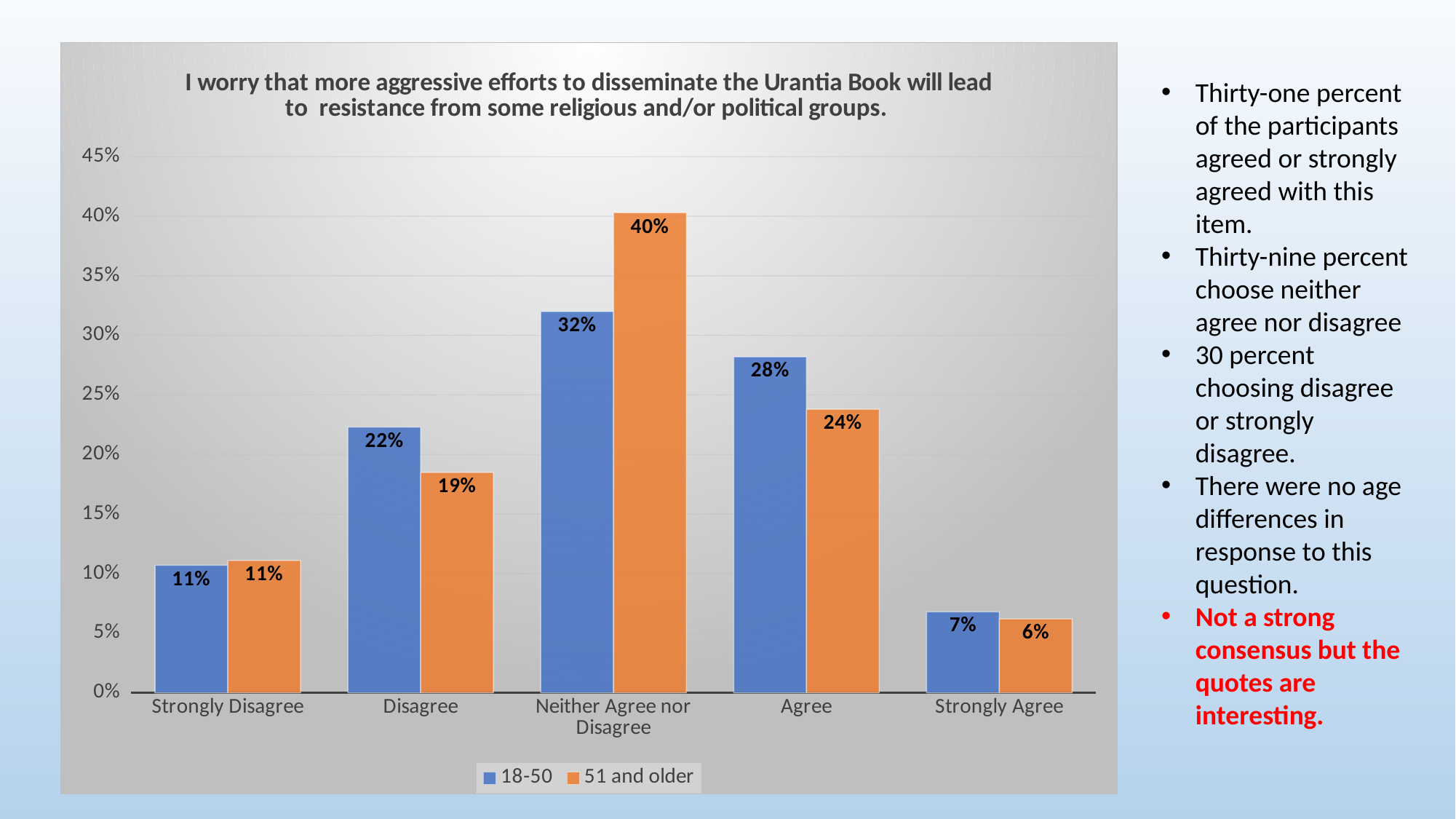
What is the value for the 51 and older series in the Agree category? 24% Is the value for the 51 and older series in the Disagree category greater or less than 20%? less What is the difference between the 51 and older and 18-50 values in the Neither Agree nor Disagree category? 8% How many categories are shown on the x axis? 5 Which colour represents the 51 and older series? Orange How many series does the legend list? 2 What is the value for the 18-50 series in the Neither Agree nor Disagree category? 32% In the Agree category, which series has the larger value, 18-50 or 51 and older? 18-50 Which category has the highest value for the 51 and older series? Neither Agree nor Disagree What kind of chart is shown on the slide? Bar chart What is the value for the 18-50 series in the Disagree category? 22% Which category has the lowest value for the 18-50 series? Strongly Agree